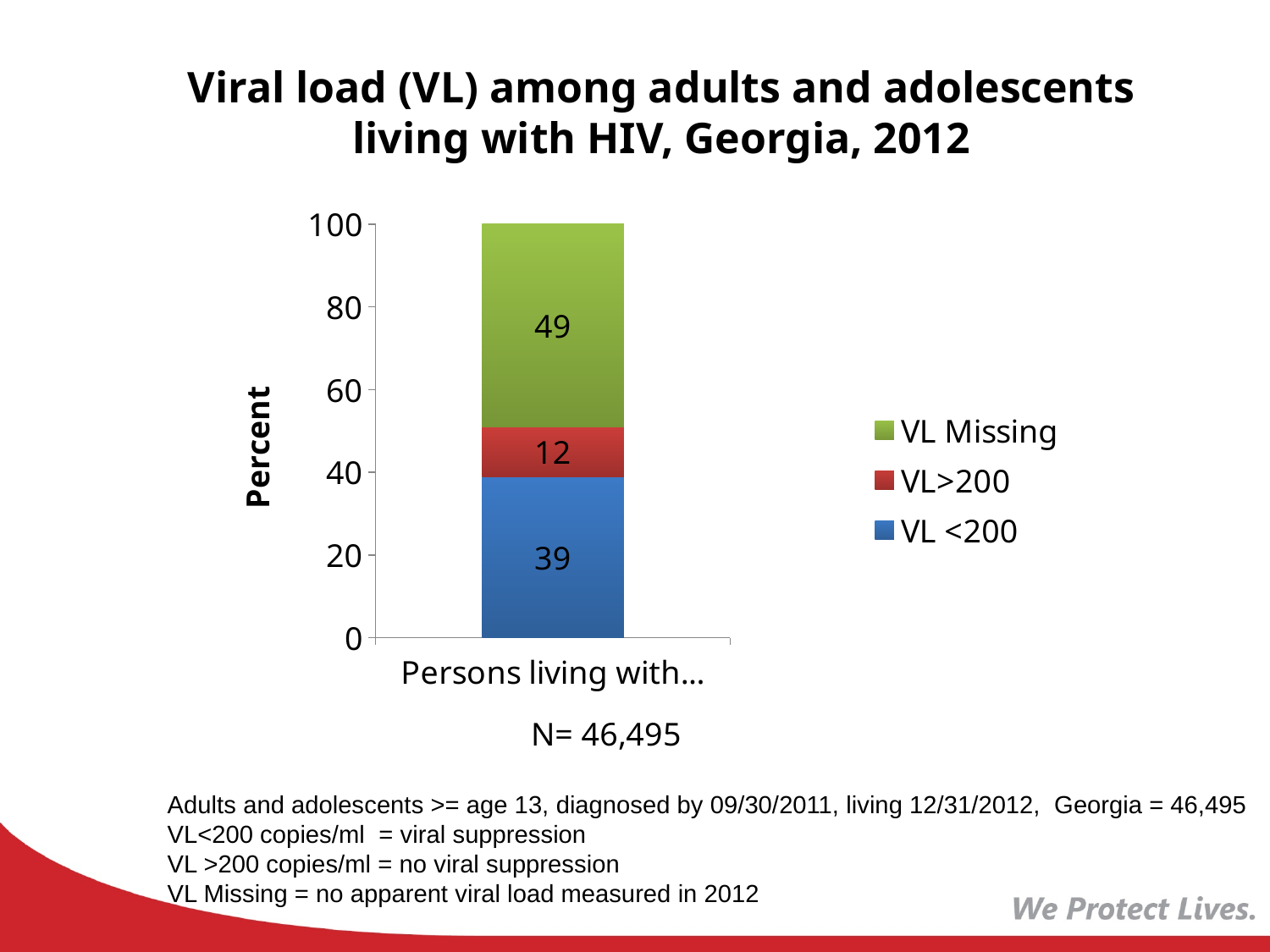
Which series has the largest share of the stacked bar? VL Missing What percentage of persons living with HIV had VL <200? 39 What is the difference between the VL <200 and VL >200 percentages? 27 What percentage of persons living with HIV had VL >200? 12 What is the total of the stacked bar? 100 What is the label of the y axis? Percent Which series has the smallest share of the stacked bar? VL>200 What kind of chart is shown on the slide? Stacked bar chart What percentage of persons living with HIV had VL Missing? 49 How many series does the legend list? 3 What is the difference between the VL Missing and VL <200 percentages? 10 Which is larger, the VL <200 share or the VL >200 share? VL <200